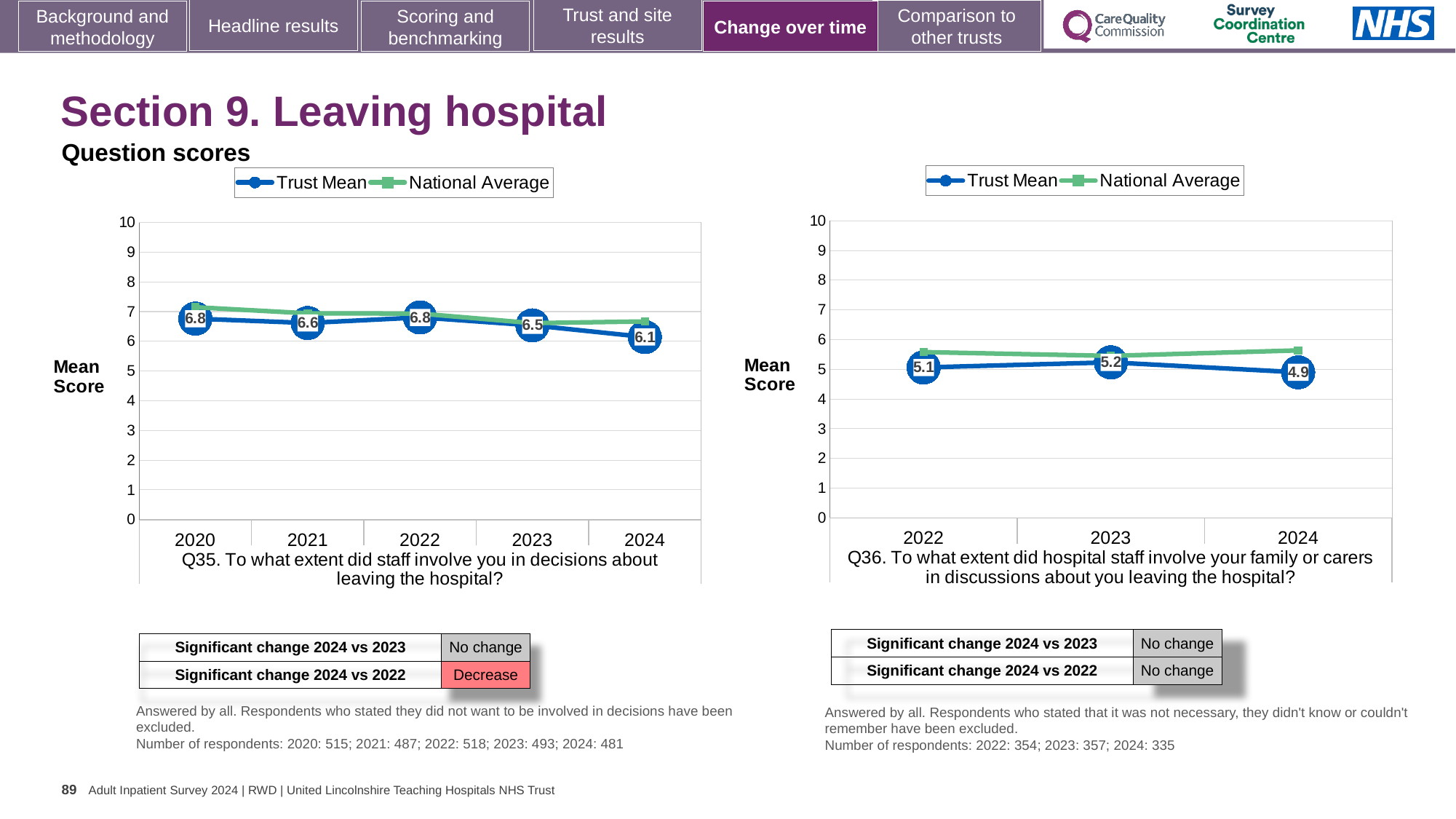
In the Q35 chart on the left, which year has the lowest Trust Mean score? 2024 In the Q35 chart on the left, what is the Trust Mean score for 2024? 6.1 In the Q36 chart on the right, what is the difference between the Trust Mean scores for 2023 and 2024? 0.3 In the Q36 chart on the right, is the National Average for 2024 greater or less than 5? greater How many series does the legend of the Q36 chart on the right list? 2 How many years are plotted on the x axis of the Q35 chart on the left? 5 In the Q35 chart on the left, what is the Trust Mean score for 2021? 6.6 In the Q36 chart on the right, which year has the lowest Trust Mean score? 2024 In the Q35 chart on the left, what is the difference between the Trust Mean scores for 2022 and 2024? 0.7 In the Q36 chart on the right, what is the Trust Mean score for 2023? 5.2 In the Q35 chart on the left, is the Trust Mean score for 2023 higher or lower than the Trust Mean score for 2024? higher What type of chart is used for the Q35 chart on the left? line chart